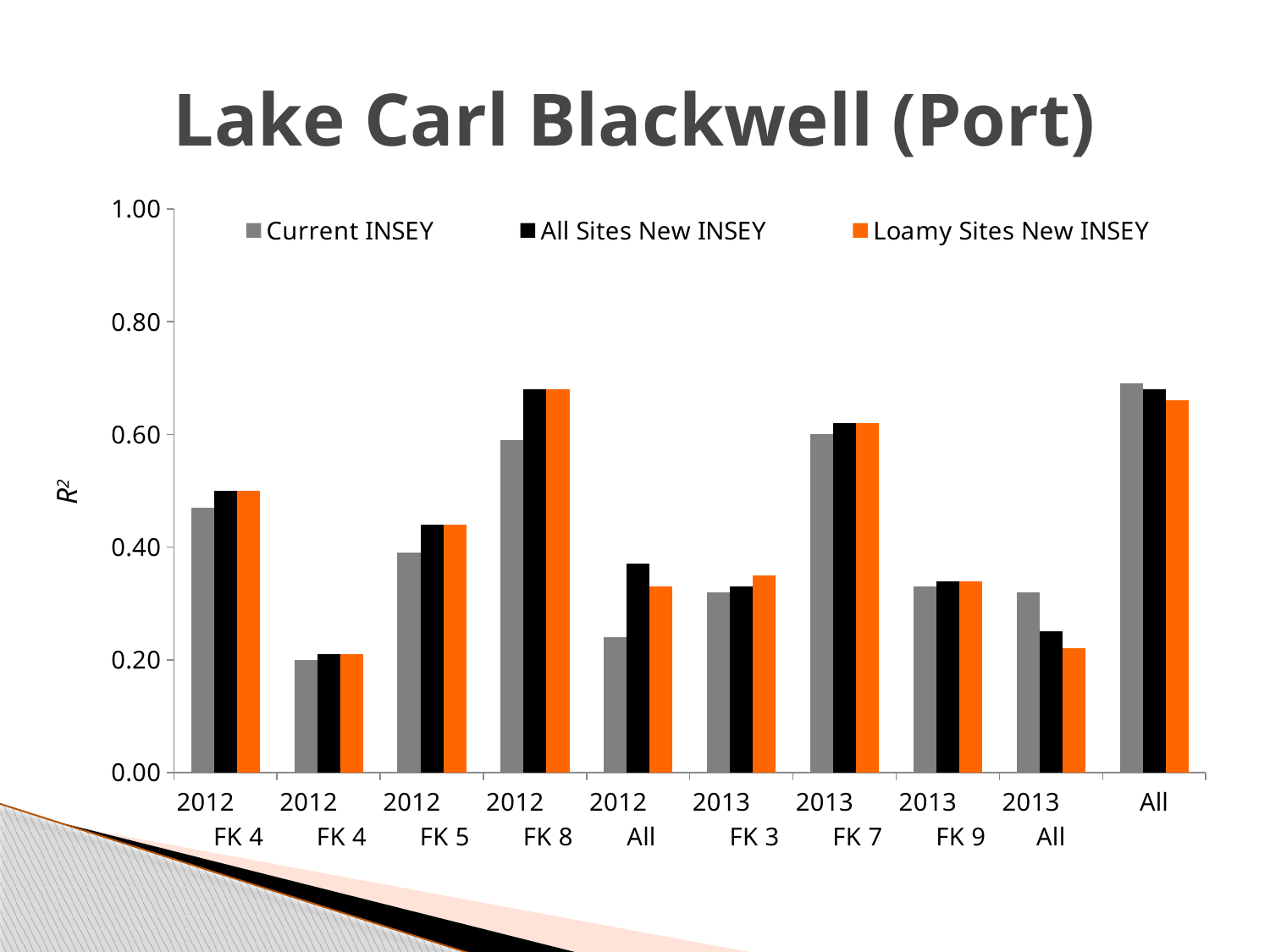
How many category groups are shown along the x axis? 10 What kind of chart is shown on the slide? bar chart Is the Current INSEY value for 2012 All greater or less than 0.40? less What is the title of the chart? Lake Carl Blackwell (Port) For 2012 All, which is larger: Current INSEY or All Sites New INSEY? All Sites New INSEY For 2013 All, which is larger: Current INSEY or Loamy Sites New INSEY? Current INSEY How many series does the legend list? 3 Which category has the highest Current INSEY value? All Is the Loamy Sites New INSEY value for 2013 All greater or less than 0.40? less Which series is shown in orange in the legend? Loamy Sites New INSEY Is the All Sites New INSEY value for 2012 FK 8 greater or less than 0.60? greater